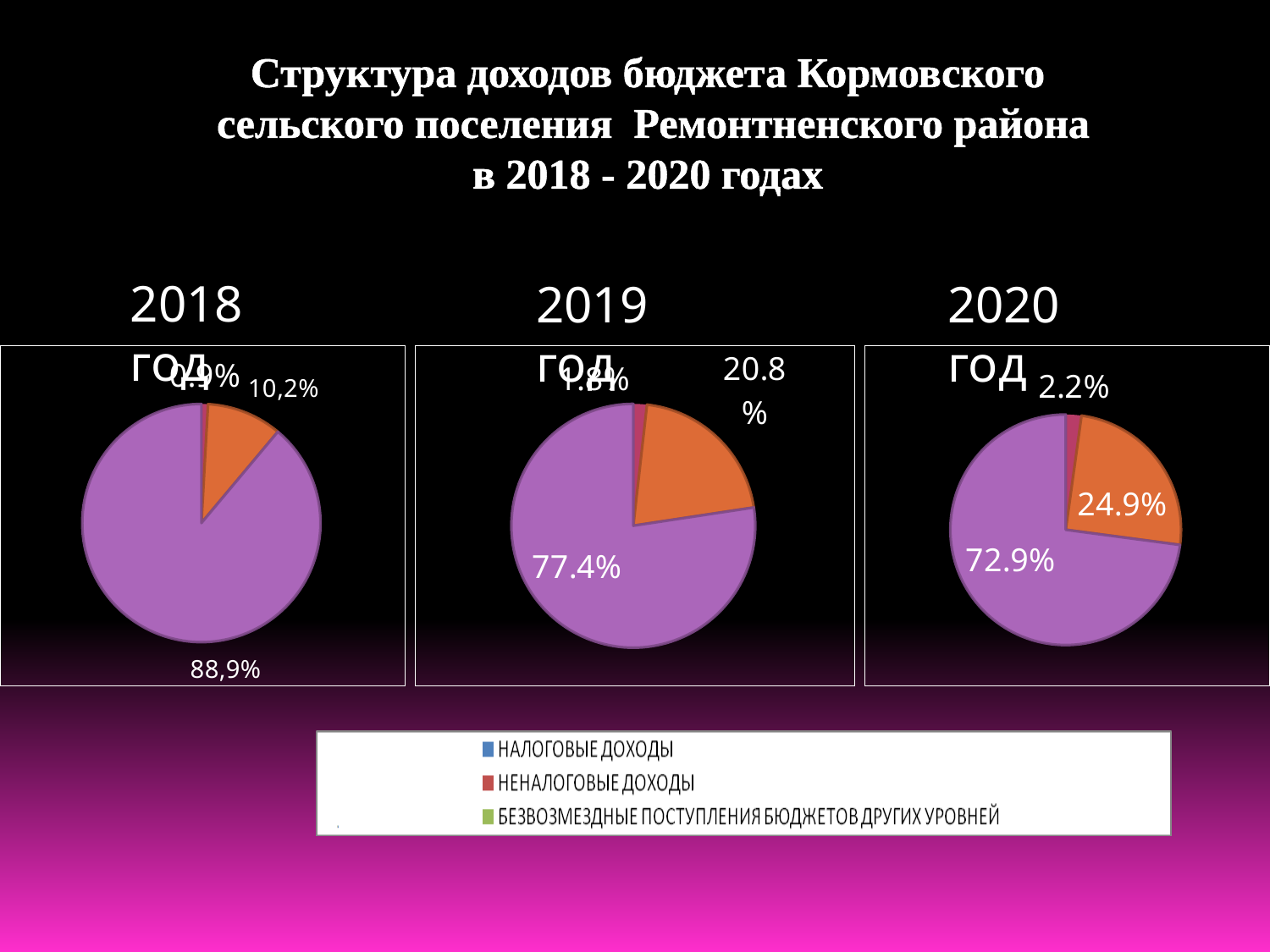
What kind of charts are shown on the slide? Pie charts In the 2018 pie chart, what value is shown for the orange slice? 10,2% In the 2020 pie chart, what is the value of the smallest slice? 2.2% Does the value of the largest slice rise or fall from the 2018 chart to the 2020 chart? Falls In the 2019 pie chart, what value is shown for the orange slice? 20.8% In the 2019 pie chart, what is the value of the largest slice? 77.4% How many pie charts are on the slide? 3 In the 2020 pie chart, what is the value of the largest slice? 72.9% Which year's pie chart has the larger orange slice, 2019 or 2020? 2020 How many entries does the legend list? 3 In the 2020 pie chart, what value is shown for the orange slice? 24.9% In the 2018 pie chart, what is the value of the largest slice? 88,9%